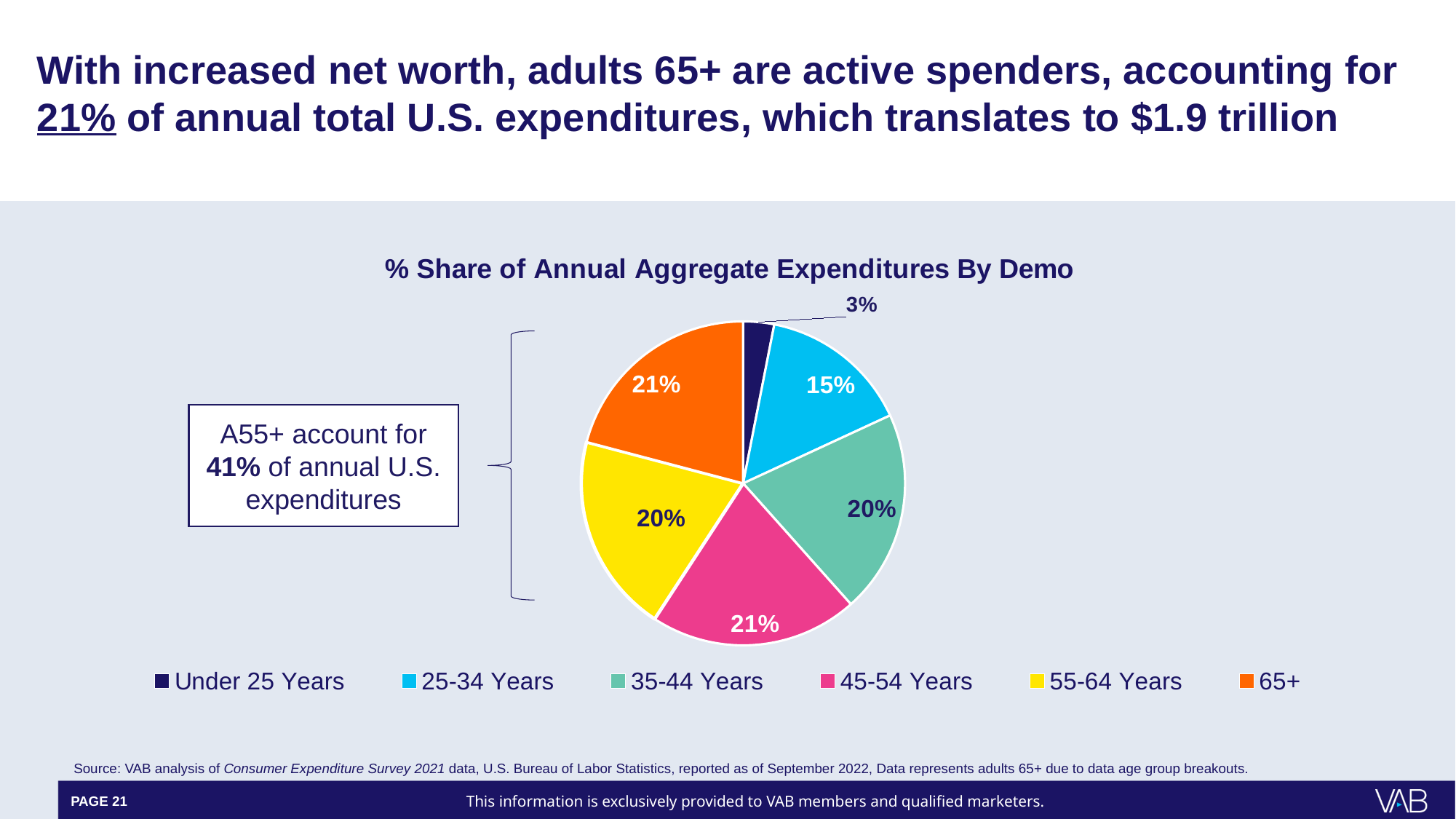
Which age group has the smallest share of annual aggregate expenditures? Under 25 Years What is the title of the chart? % Share of Annual Aggregate Expenditures By Demo Which has a larger share of expenditures, the 25-34 Years group or the 45-54 Years group? 45-54 Years What colour represents the 65+ group in the pie chart? Orange What kind of chart is shown on the slide? Pie chart What is the combined share of the 55-64 Years and 65+ groups? 41% What share of annual aggregate expenditures is attributed to the 25-34 Years group? 15% What share of annual aggregate expenditures is attributed to the 55-64 Years group? 20% What share of annual aggregate expenditures is attributed to the 65+ group? 21% How many age groups does the legend list? 6 What is the difference in share between the 35-44 Years group and the 25-34 Years group? 5% What share of annual aggregate expenditures is attributed to the Under 25 Years group? 3%